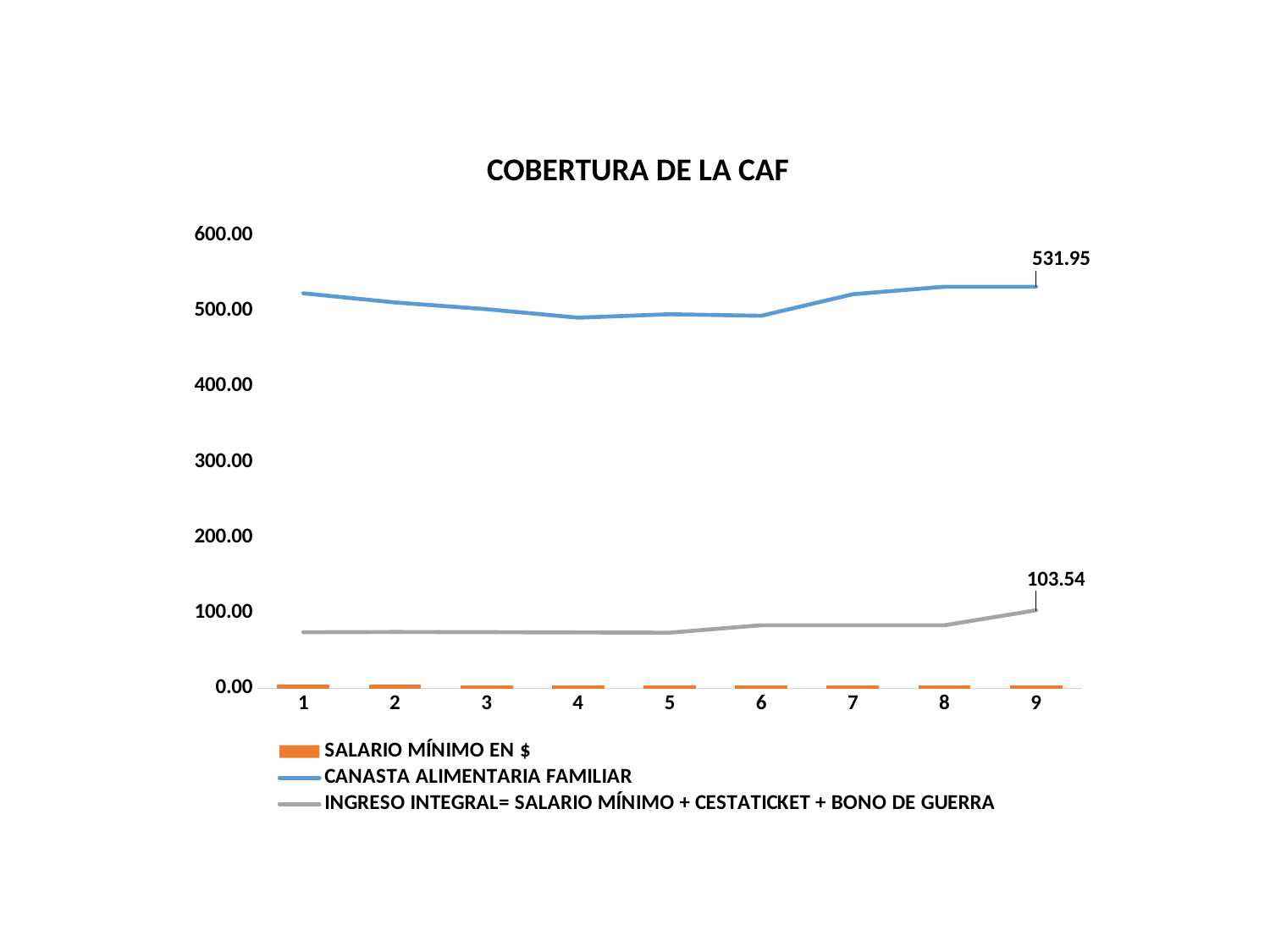
What is the value of CANASTA ALIMENTARIA FAMILIAR at point 9? 531.95 Is the value for INGRESO INTEGRAL at point 1 greater or less than 100.00? less At which point is INGRESO INTEGRAL highest? 9 What is the title of the chart? COBERTURA DE LA CAF What kind of chart is used to plot CANASTA ALIMENTARIA FAMILIAR? line chart At point 9, which is larger: CANASTA ALIMENTARIA FAMILIAR or INGRESO INTEGRAL? CANASTA ALIMENTARIA FAMILIAR Is the value for CANASTA ALIMENTARIA FAMILIAR at point 1 greater or less than 500.00? greater What is the difference between CANASTA ALIMENTARIA FAMILIAR and INGRESO INTEGRAL at point 9? 428.41 How many series does the legend list? 3 How many points are shown along the x axis? 9 Does INGRESO INTEGRAL rise or fall from point 6 to point 9? rise What is the value of INGRESO INTEGRAL= SALARIO MÍNIMO + CESTATICKET + BONO DE GUERRA at point 9? 103.54